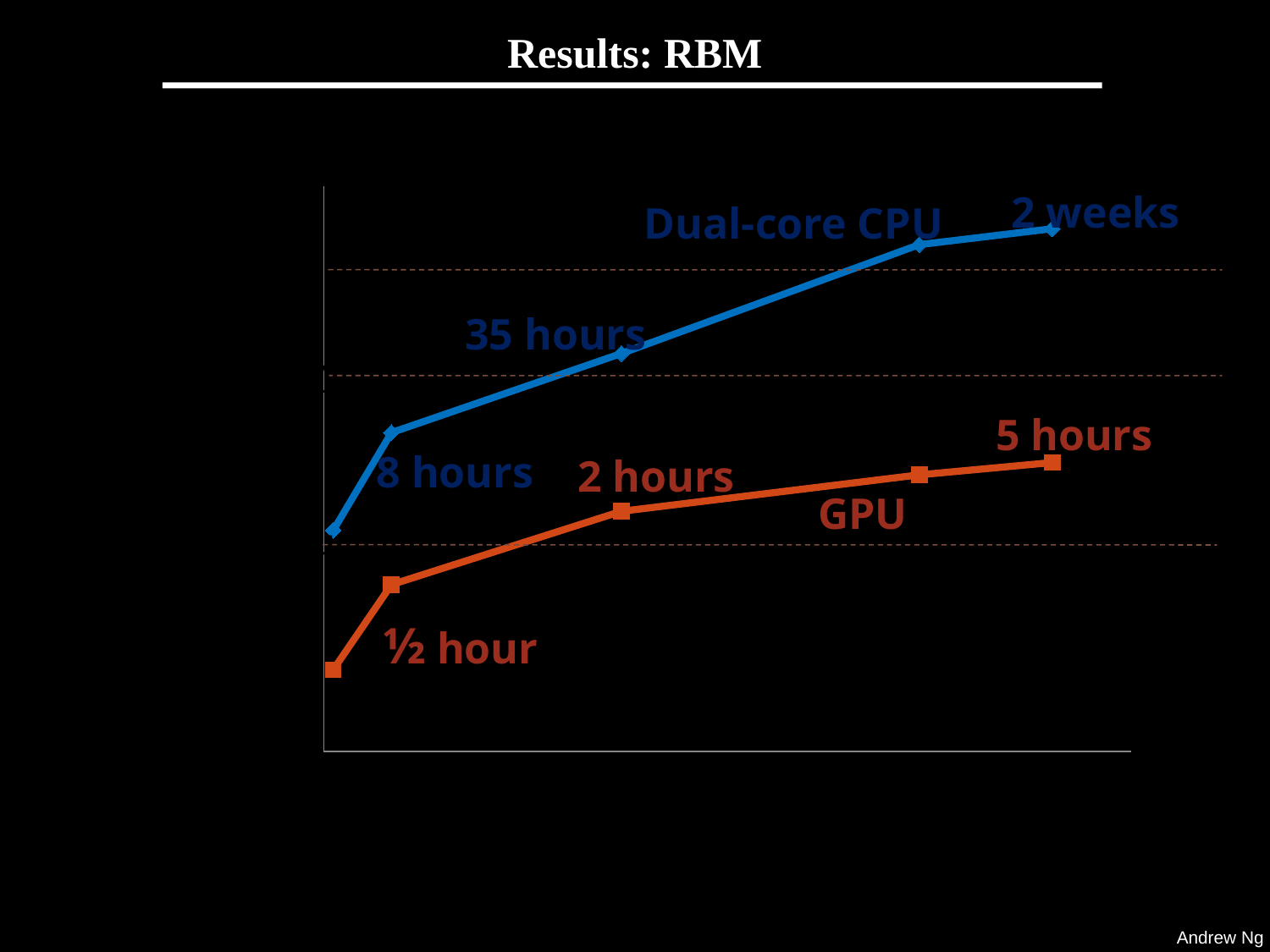
Do the values of the GPU line rise or fall from left to right? rise What is the title of the slide? Results: RBM How many data points does the GPU line have? 5 How many data points does the Dual-core CPU line have? 5 What kind of chart is shown on the slide? line chart What are the names of the two series plotted on the chart? Dual-core CPU and GPU What time label is shown at the rightmost point of the Dual-core CPU line? 2 weeks What time label is shown at the rightmost point of the GPU line? 5 hours Which series has the higher values across the chart, Dual-core CPU or GPU? Dual-core CPU How many series are plotted on the chart? 2